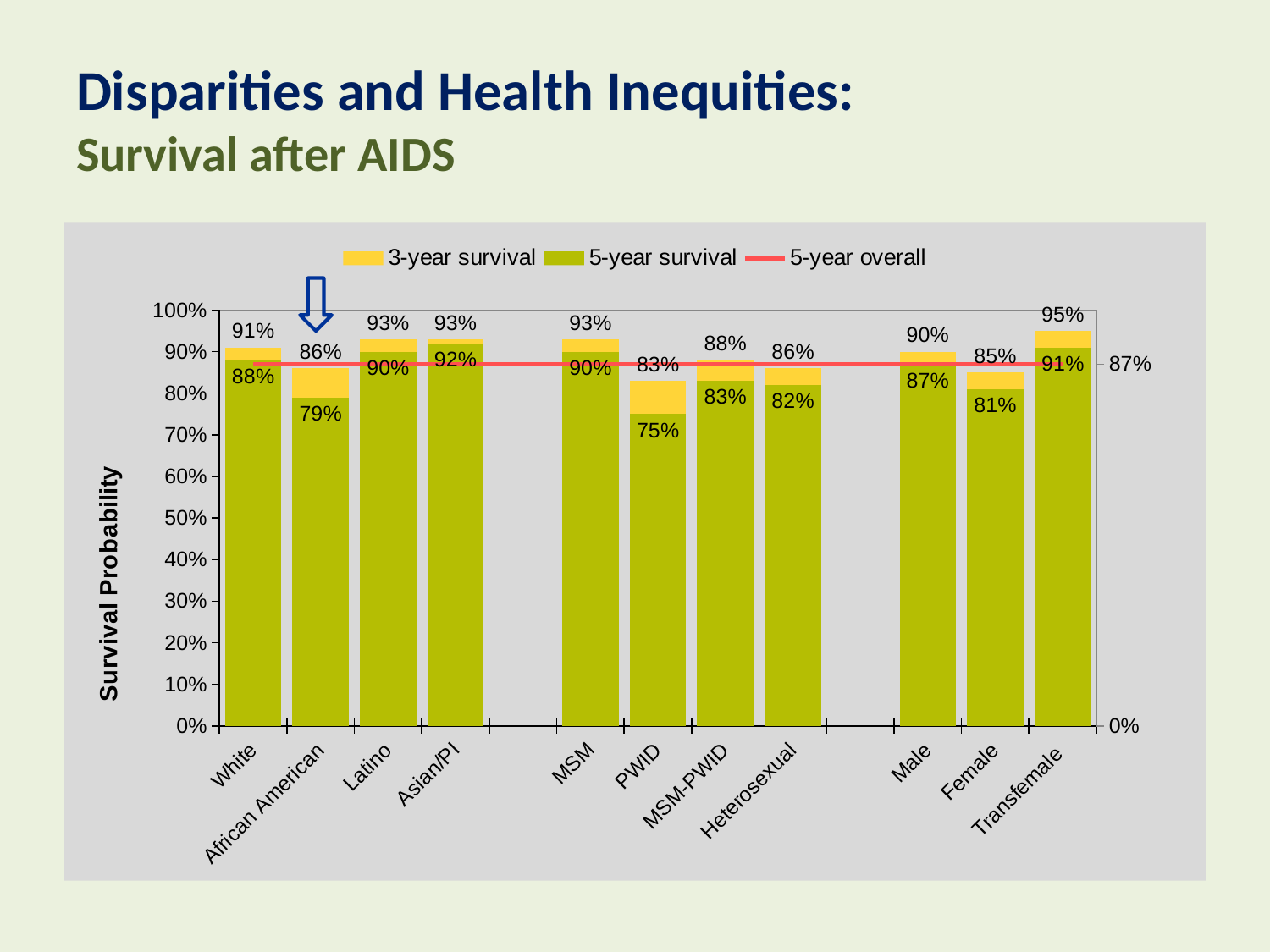
What is the 3-year survival value for Transfemale? 95% Which has the higher 5-year survival, Male or Female? Male What is the difference between the 3-year survival and 5-year survival for PWID? 8% How many categories are shown on the x axis? 11 Is the 5-year survival for PWID greater or less than 80%? less What value does the 5-year overall line show? 87% What is the title of the y axis? Survival Probability What kind of chart is this? combination bar and line chart Which category has the lowest 5-year survival? PWID Which category has the highest 5-year survival? Asian/PI How many series does the legend list? 3 What is the 5-year survival value for African American? 79%